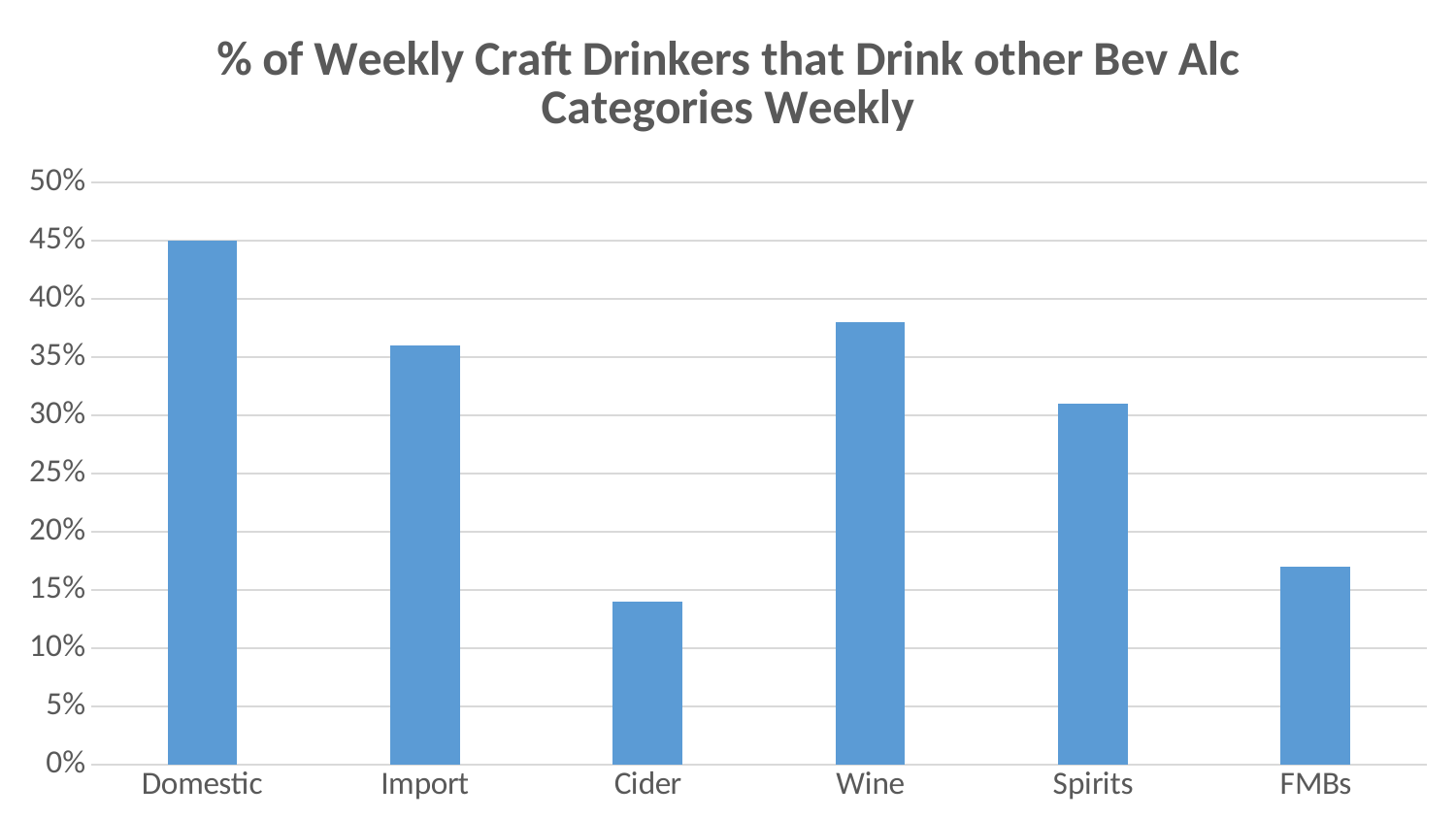
Is the value for Wine greater or less than 40%? less Is the value for Spirits greater or less than 30%? greater What is the title of the chart? % of Weekly Craft Drinkers that Drink other Bev Alc Categories Weekly Is the value for Cider greater or less than 15%? less Which category has the highest value? Domestic What type of chart is shown on the slide? bar chart Which category has the lowest value? Cider What is the value for Domestic? 45% How many categories are shown on the x axis? 6 Which is larger, the value for Wine or the value for Spirits? Wine